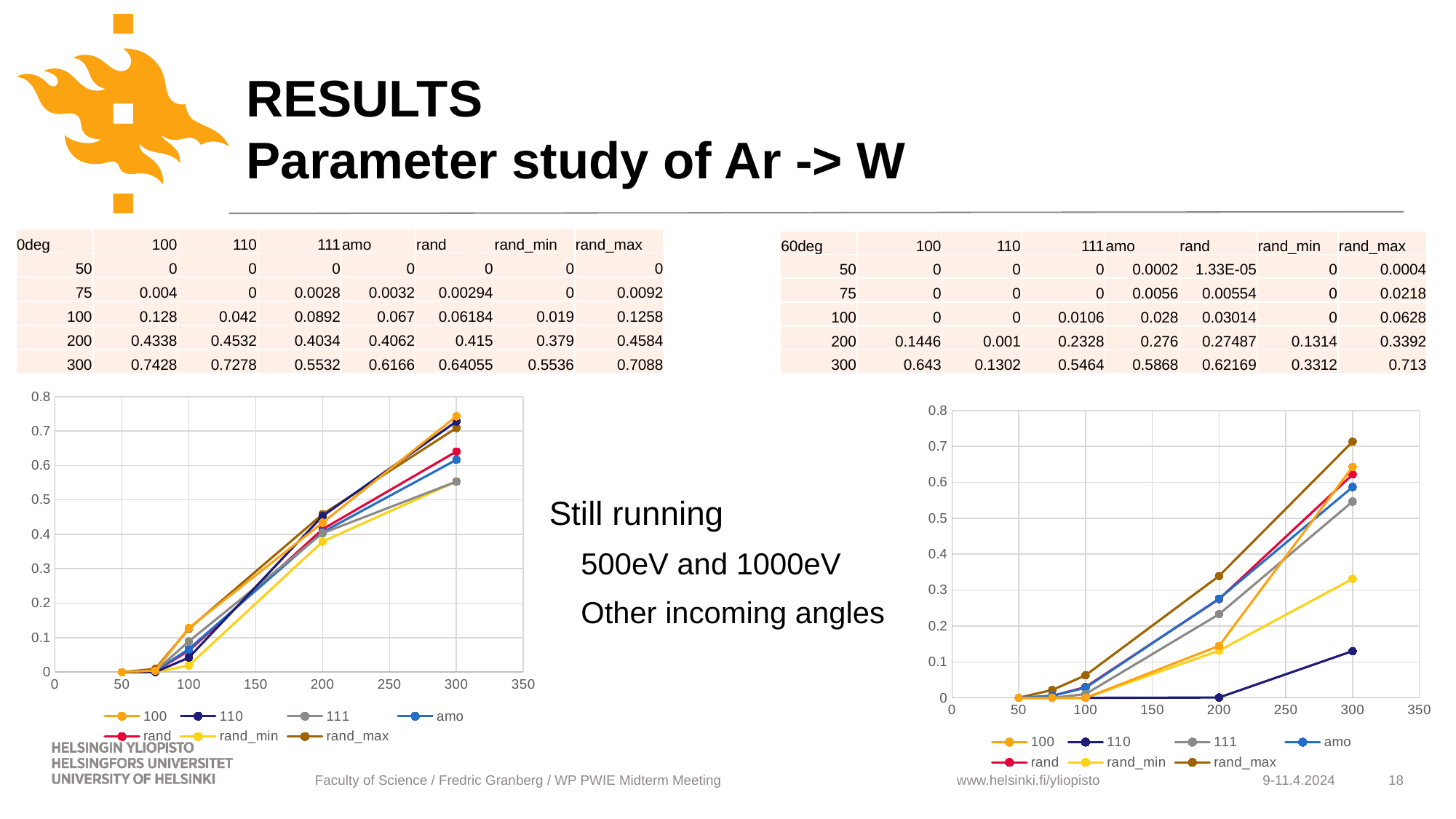
In the left chart (0deg), what is the value of the amo series at x = 100? 0.067 How many data points does each series in the left chart (0deg) have? 5 In the left chart (0deg), does the 100 series rise or fall as x increases from 50 to 300? rises In the right chart (60deg), which series has the lowest value at x = 300? 110 In the right chart (60deg), which series has the highest value at x = 300? rand_max In the right chart (60deg), is the value of the 110 series at x = 300 greater or less than 0.2? less In the left chart (0deg), which is larger at x = 200: the 110 series or the rand_min series? 110 What kind of chart is the left chart (0deg)? line chart In the right chart (60deg), what is the value of the rand_min series at x = 200? 0.1314 How many series does the legend of the right chart (60deg) list? 7 In the left chart (0deg), what is the value of the 100 series at x = 300? 0.7428 In the right chart (60deg), what is the difference between the rand_max and 110 series at x = 300? 0.5828